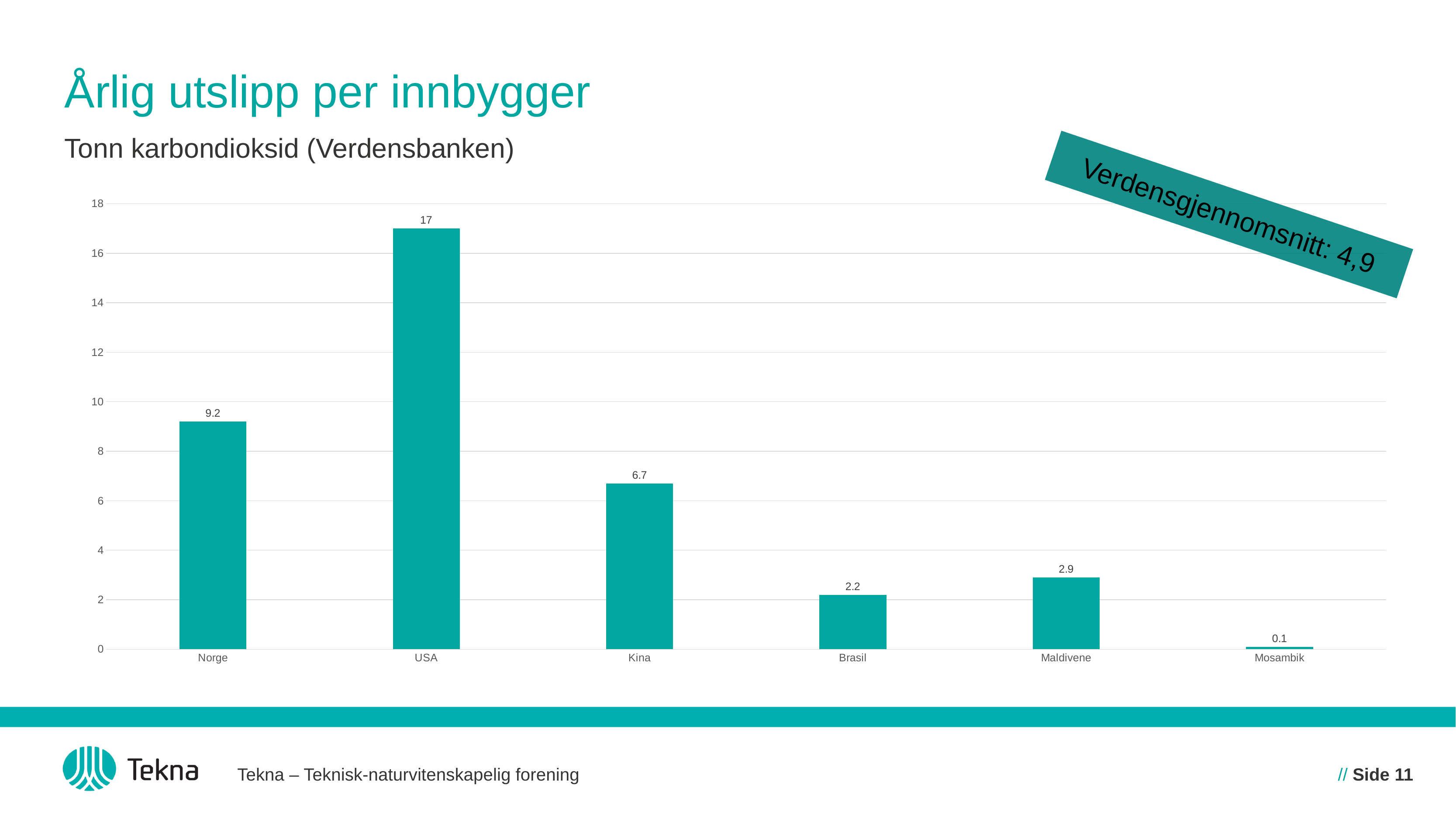
How many countries are shown in the chart? 6 What is the difference between the values for USA and Norge? 7.8 What world average (Verdensgjennomsnitt) is stated on the slide? 4,9 Which country has the lowest annual emission per capita? Mosambik What is the difference between the values for Maldivene and Brasil? 0.7 What kind of chart is shown on the slide? Bar chart What is the value shown for USA? 17 Which country has the highest annual emission per capita? USA Which is larger, the value for Kina or the value for Maldivene? Kina What is the annual emission per capita for Norge? 9.2 What is the value shown for Mosambik? 0.1 What is the value shown for Kina? 6.7